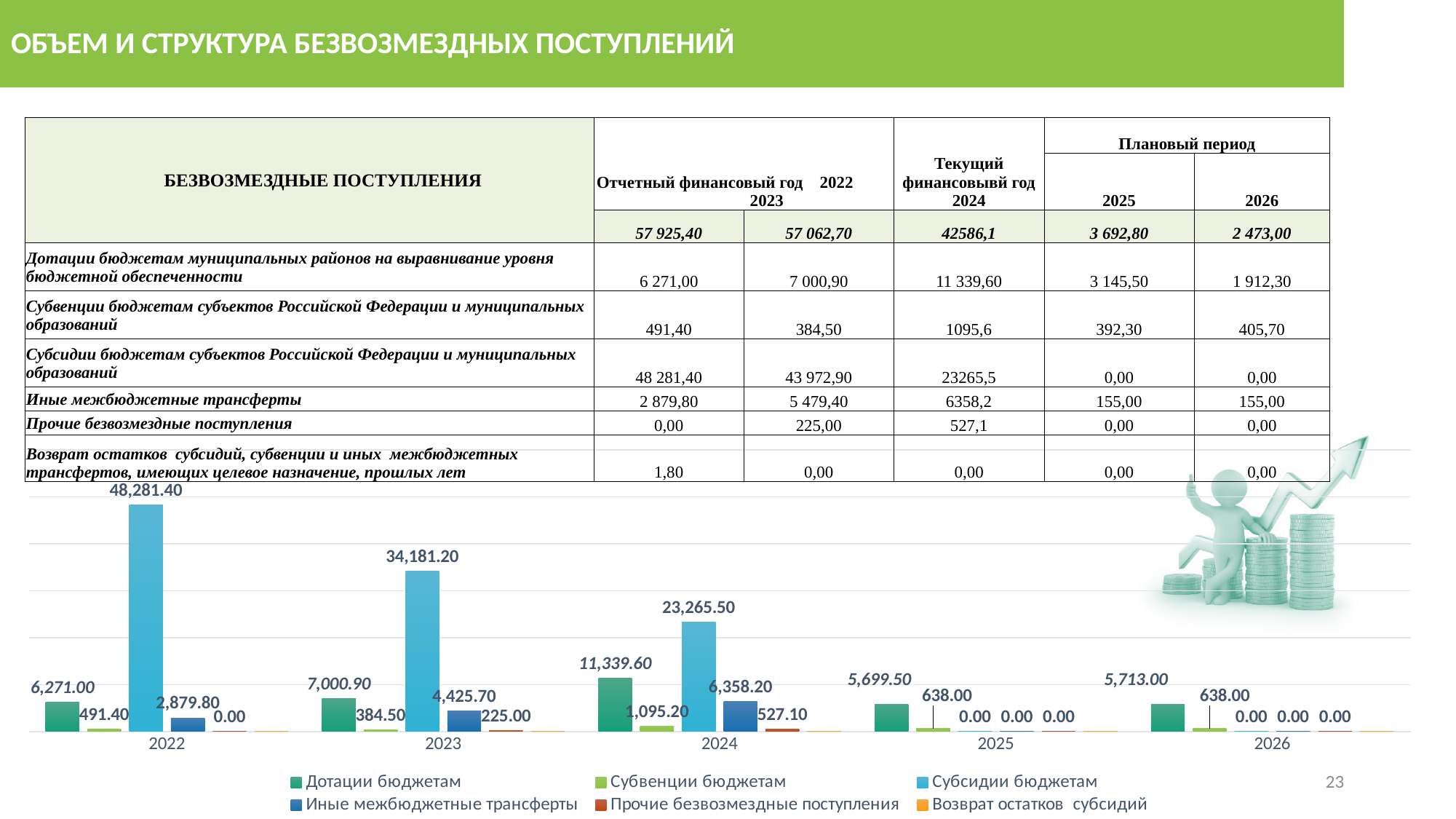
In the bar chart, which year has the lowest value for Дотации бюджетам? 2025 How many series does the legend of the bar chart list? 6 In the bar chart, which year has the highest value for Субсидии бюджетам? 2022 In the bar chart, what is the value of Дотации бюджетам for 2024? 11,339.60 In the bar chart, what is the difference between the Субсидии бюджетам values for 2022 and 2023? 14,100.20 In the bar chart, what is the value of Иные межбюджетные трансферты for 2023? 4,425.70 In the bar chart, does the value of Субсидии бюджетам rise or fall from 2022 to 2024? fall In the bar chart, what is the value of Субвенции бюджетам for 2026? 638.00 What type of chart is shown at the bottom of the slide? bar chart In the bar chart, what is the value of Субсидии бюджетам for 2022? 48,281.40 In the bar chart, what is the value of Прочие безвозмездные поступления for 2024? 527.10 In the bar chart, which is larger for 2024: Дотации бюджетам or Субсидии бюджетам? Субсидии бюджетам